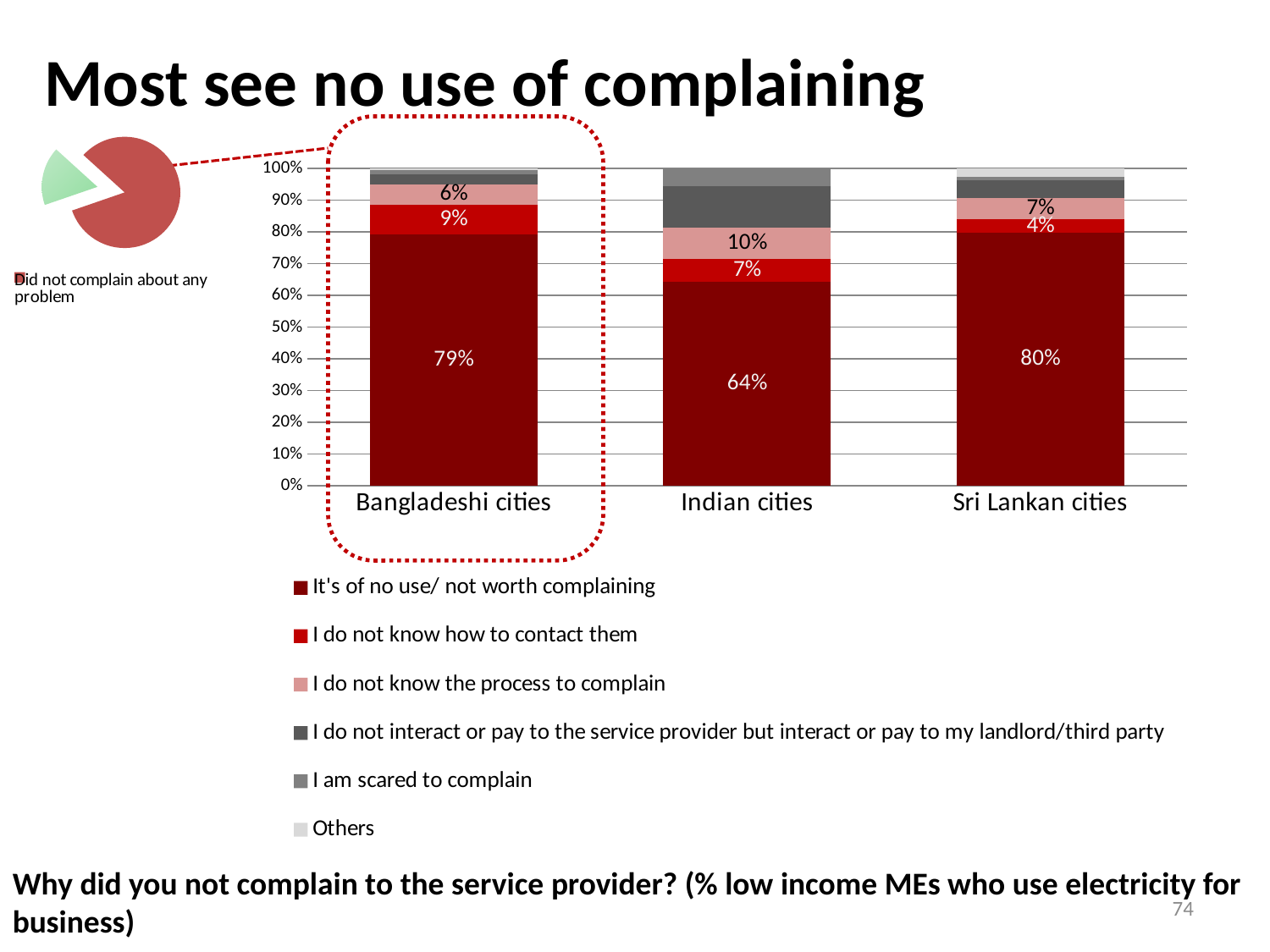
In the stacked bar chart, which city group has the lowest share saying it's of no use/not worth complaining? Indian cities In the stacked bar chart, which city group has the highest share for 'I do not know the process to complain'? Indian cities In the stacked bar chart, what percentage of respondents in Bangladeshi cities said it's of no use/not worth complaining? 79% What is the legend entry shown under the small pie chart at the top left of the slide? Did not complain about any problem In the stacked bar chart, how many series does the legend list? 6 In the stacked bar chart, what is the value for 'I do not know how to contact them' in Sri Lankan cities? 4% In the stacked bar chart, how many city groups are shown on the x axis? 3 In the stacked bar chart, what is the value for 'I do not know how to contact them' in Indian cities? 7% In the stacked bar chart, is the 'It's of no use/not worth complaining' share larger in Bangladeshi cities or Indian cities? Bangladeshi cities In the stacked bar chart, what is the value for 'I do not know the process to complain' in Sri Lankan cities? 7% What type of chart is the large chart in the centre of the slide? Stacked bar chart In the stacked bar chart, what is the difference in percentage points between Bangladeshi cities and Indian cities for 'It's of no use/not worth complaining'? 15 percentage points